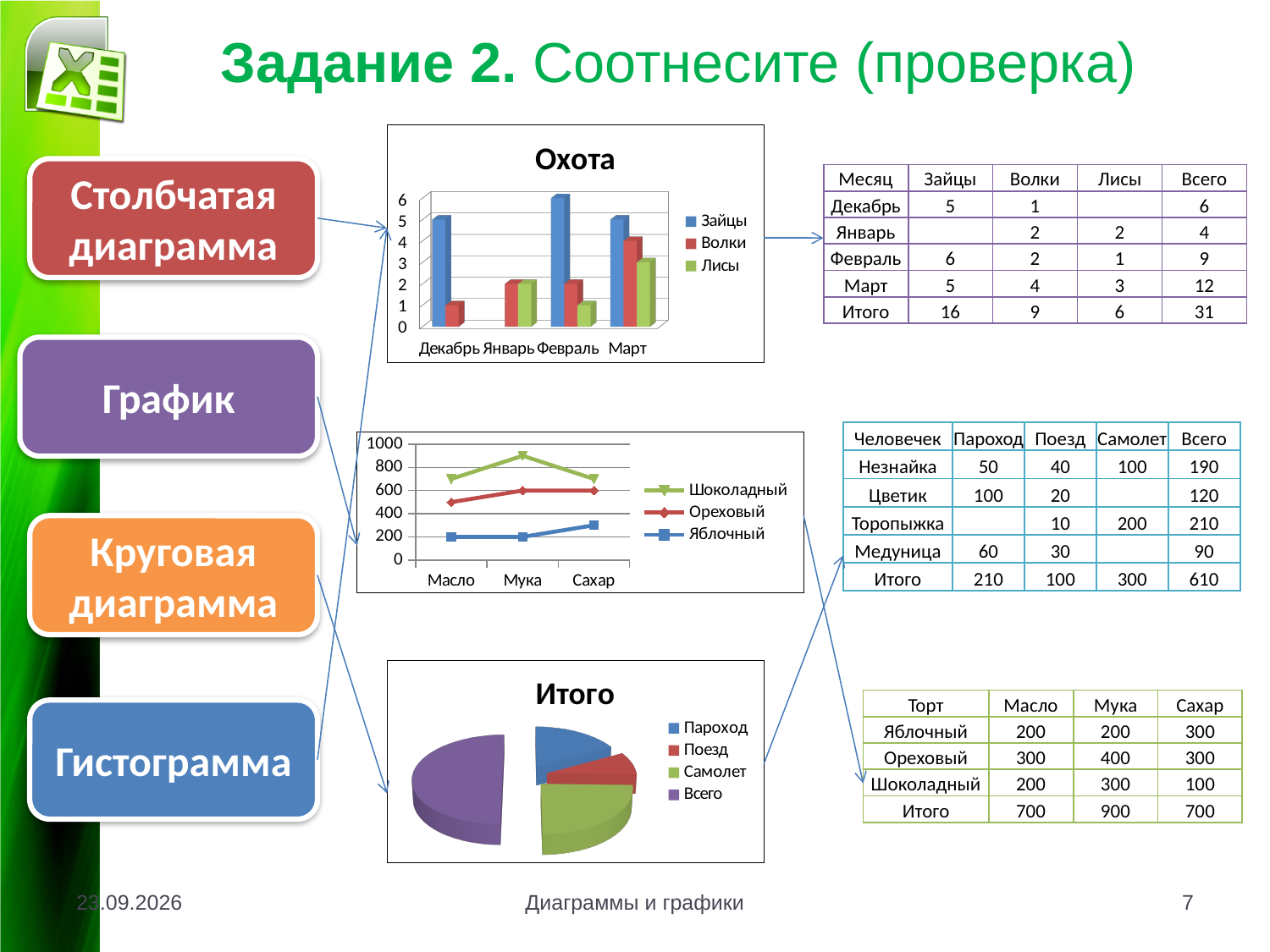
What kind of chart is the middle chart with the categories Масло, Мука and Сахар? line chart In the chart titled "Охота", how many months are shown on the x axis? 4 In the chart titled "Охота", how many series does the legend list? 3 In the chart titled "Охота", which month has the highest value for Зайцы? Февраль In the chart titled "Охота", what is the value for Зайцы in Февраль? 6 In the middle line chart, which series has the highest value at Мука? Шоколадный In the middle line chart, is the value for Шоколадный at Мука greater or less than 800? greater In the middle line chart, what is the value for Яблочный at Масло? 200 In the middle line chart, how many series does the legend list? 3 What kind of chart is the chart titled "Охота"? bar chart In the chart titled "Охота", which is larger in Март: Волки or Лисы? Волки In the pie chart titled "Итого", which slice is the largest? Всего